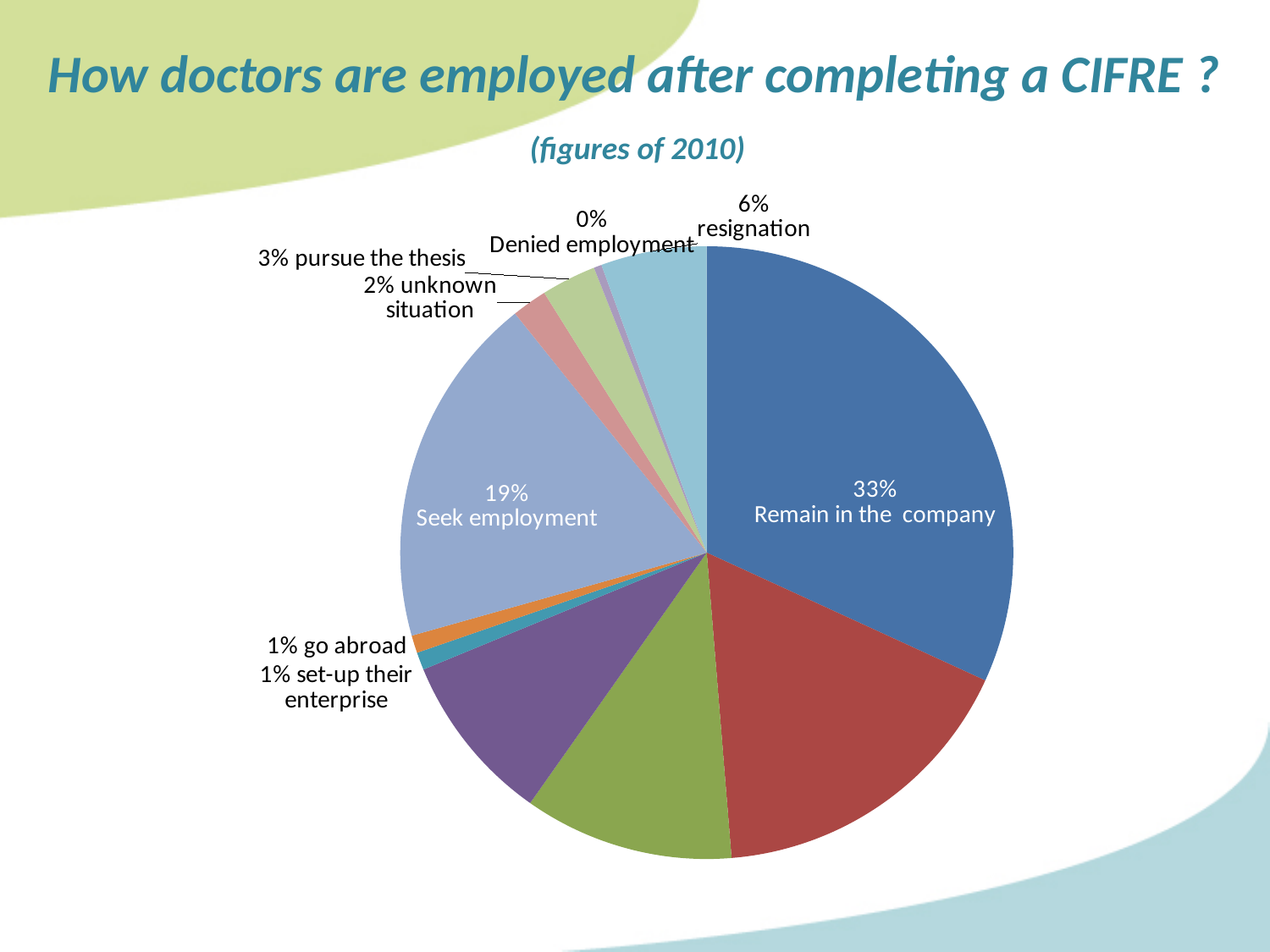
What percentage is shown for 'Denied employment'? 0% What percentage of doctors pursue the thesis? 3% What percentage of doctors seek employment? 19% According to the subtitle, which year do the figures refer to? 2010 What percentage of doctors go abroad? 1% What kind of chart is shown on the slide? pie chart What percentage of doctors remain in the company after completing a CIFRE? 33% What is the difference in percentage points between 'Remain in the company' and 'Seek employment'? 14 Which is larger: the share for resignation or the share for pursue the thesis? resignation What percentage is shown for 'unknown situation'? 2% Which category has the largest share of the pie? Remain in the company What share of the pie corresponds to resignation? 6%